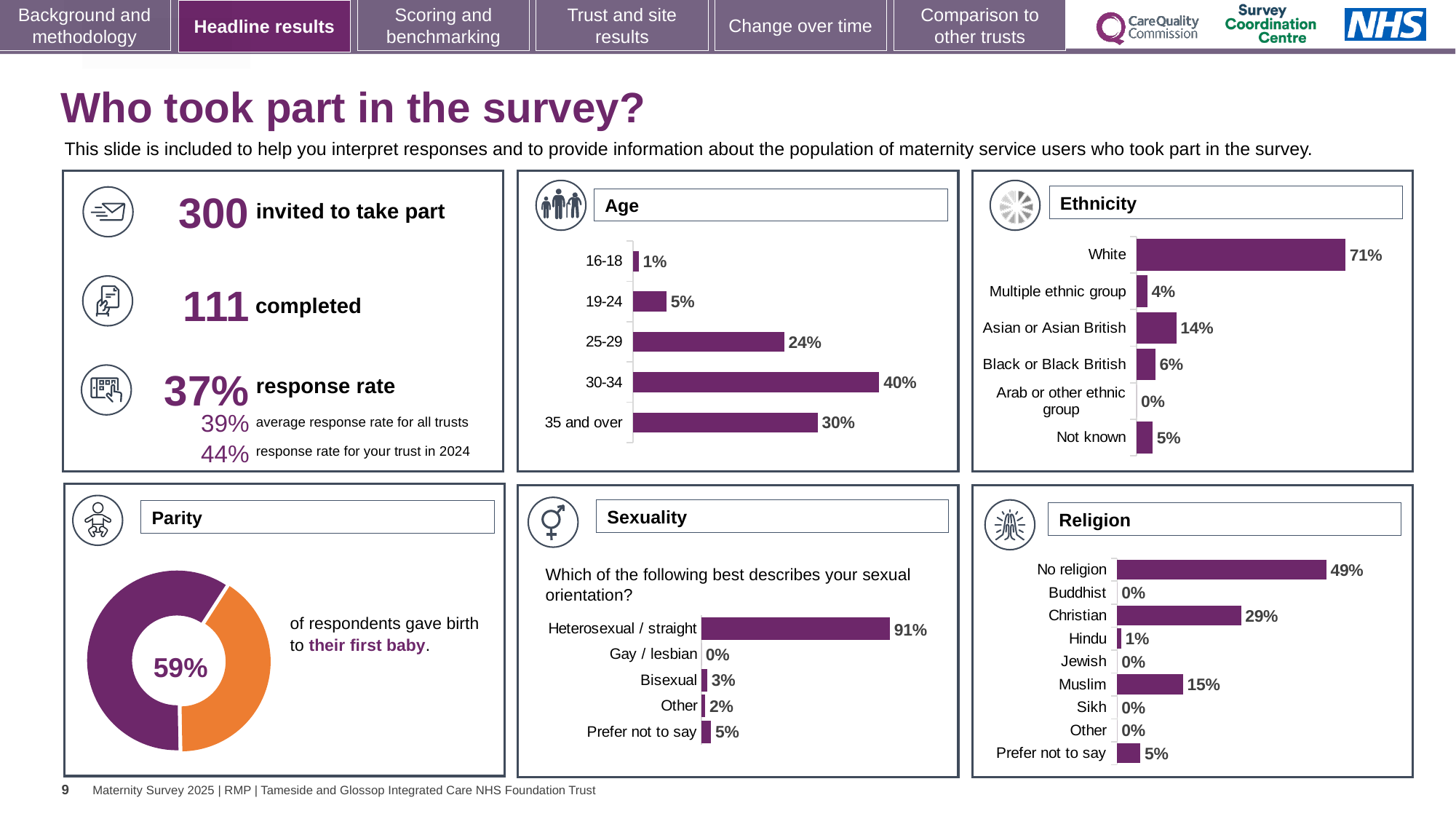
In the Age chart, which age group has the lowest percentage? 16-18 In the Ethnicity chart, what is the difference between Asian or Asian British and Black or Black British? 8% In the Age chart, what percentage of respondents were aged 30-34? 40% In the Religion chart, what is the difference between No religion and Christian? 20% In the Ethnicity chart, which category has the highest percentage? White In the Ethnicity chart, what percentage of respondents were White? 71% In the Age chart, how many age categories are shown? 5 In the Religion chart, what percentage of respondents were Muslim? 15% In the Parity chart, what percentage of respondents gave birth to their first baby? 59% What kind of chart is the Parity chart? Doughnut chart In the Sexuality chart, which is larger: Prefer not to say or Other? Prefer not to say In the Sexuality chart, what percentage of respondents answered Bisexual? 3%